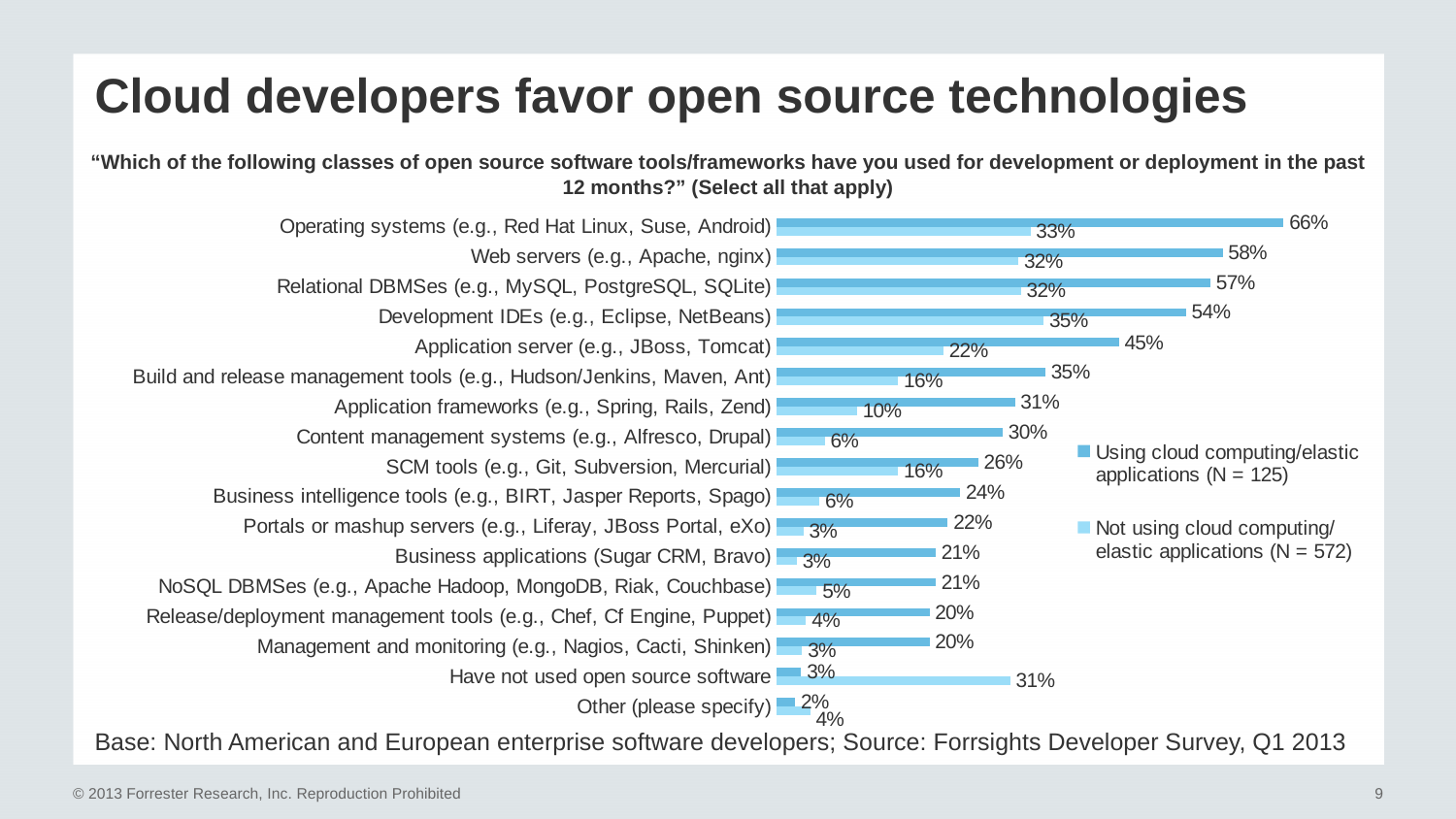
Which class of open source software has the highest value for developers using cloud computing/elastic applications? Operating systems (e.g., Red Hat Linux, Suse, Android) What percentage of developers using cloud computing/elastic applications have used operating systems (e.g., Red Hat Linux, Suse, Android)? 66% What type of chart is shown on the slide? Bar chart What percentage of developers not using cloud computing/elastic applications have not used open source software? 31% What percentage of developers using cloud computing/elastic applications have used SCM tools (e.g., Git, Subversion, Mercurial)? 26% What is the difference between the 'Using cloud computing' and 'Not using cloud computing' values for application server (e.g., JBoss, Tomcat)? 23% Which category has the lowest value for developers using cloud computing/elastic applications? Other (please specify) How many series does the legend list? 2 What is the sample size (N) for the 'Not using cloud computing/elastic applications' series? 572 For content management systems (e.g., Alfresco, Drupal), which group has the larger value: using cloud computing or not using cloud computing? Using cloud computing/elastic applications How many categories are shown in the chart? 17 What percentage of developers not using cloud computing/elastic applications have used development IDEs (e.g., Eclipse, NetBeans)? 35%